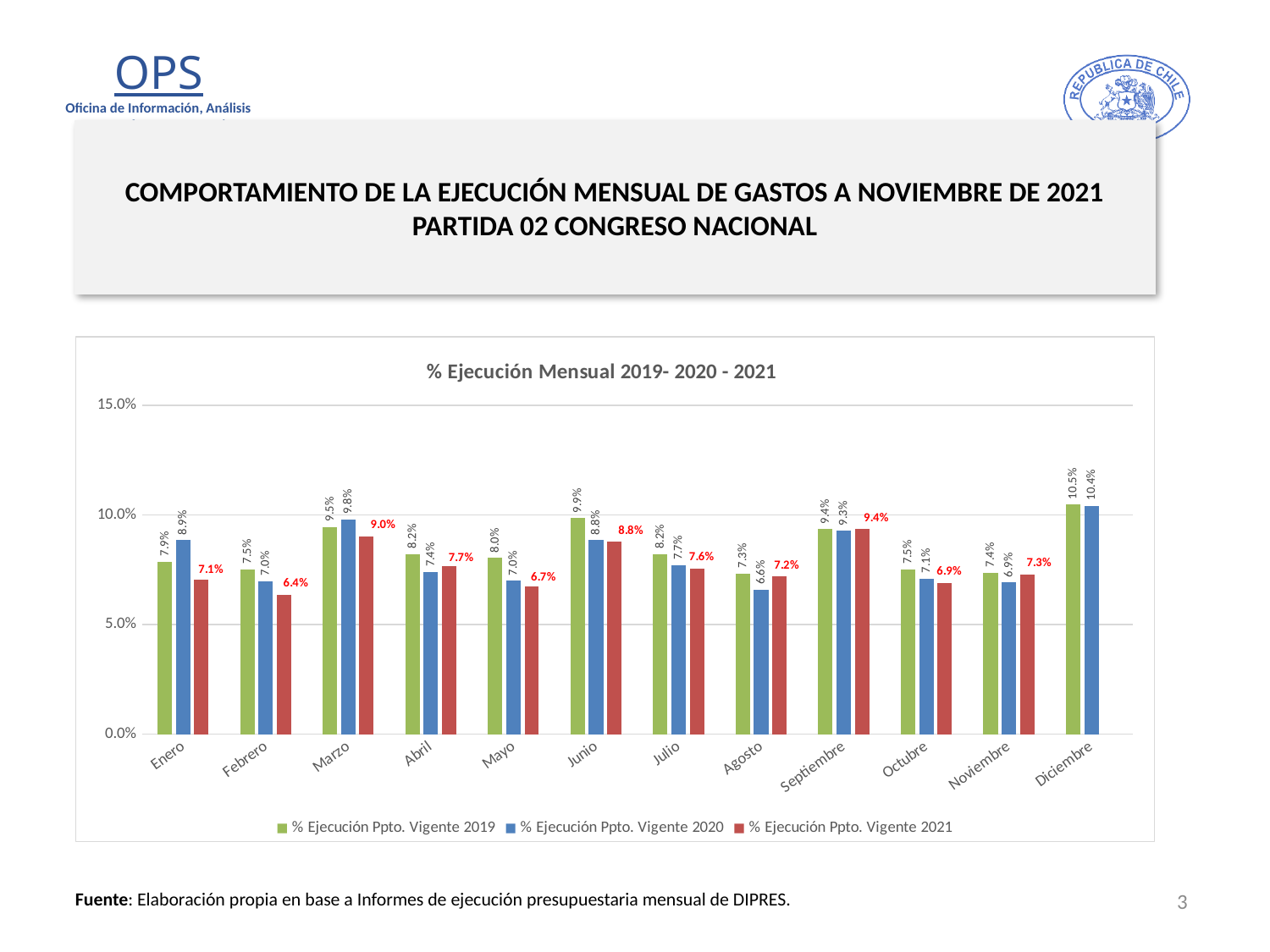
What is the difference between the 2020 and 2021 values in Enero? 1.8 percentage points Which month has the lowest value for % Ejecución Ppto. Vigente 2021? Febrero Which month has the highest value for % Ejecución Ppto. Vigente 2021? Septiembre What is the value for % Ejecución Ppto. Vigente 2021 in Marzo? 9.0% What is the value for % Ejecución Ppto. Vigente 2019 in Junio? 9.9% What is the value for % Ejecución Ppto. Vigente 2020 in Agosto? 6.6% What is the value for % Ejecución Ppto. Vigente 2020 in Diciembre? 10.4% What kind of chart is shown on the slide? Bar chart How many series does the legend list? 3 Which month has the highest value for % Ejecución Ppto. Vigente 2019? Diciembre In Abril, which is larger: the 2020 value or the 2021 value? 2021 (7.7%) How many months are shown on the x axis? 12